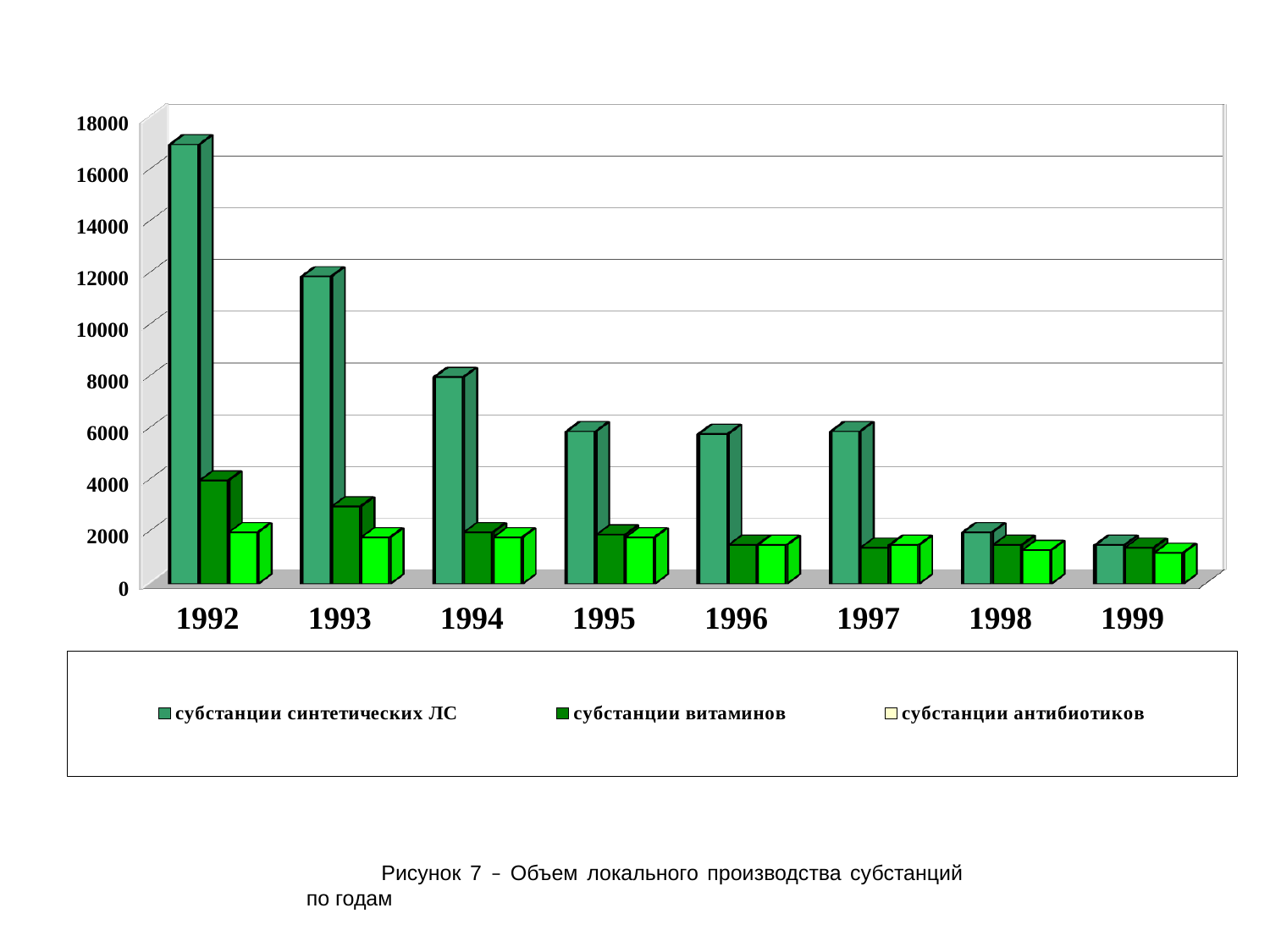
In which year is the value for субстанции витаминов highest? 1992 In which year is the value for субстанции синтетических ЛС lowest? 1999 Is the value for субстанции витаминов in 1992 greater or less than 2000? greater How many years are shown along the x axis of the chart? 8 Which is larger: the value for субстанции синтетических ЛС in 1992 or in 1993? 1992 Is the value for субстанции синтетических ЛС in 1994 greater or less than 10000? less What kind of chart is shown on the slide? bar chart How many series does the chart's legend list? 3 Do the values for субстанции синтетических ЛС generally rise or fall from 1992 to 1999? fall In which year is the value for субстанции синтетических ЛС highest? 1992 Which series is shown in the lightest (bright green) colour in the legend? субстанции антибиотиков Is the value for субстанции синтетических ЛС in 1992 greater or less than 16000? greater